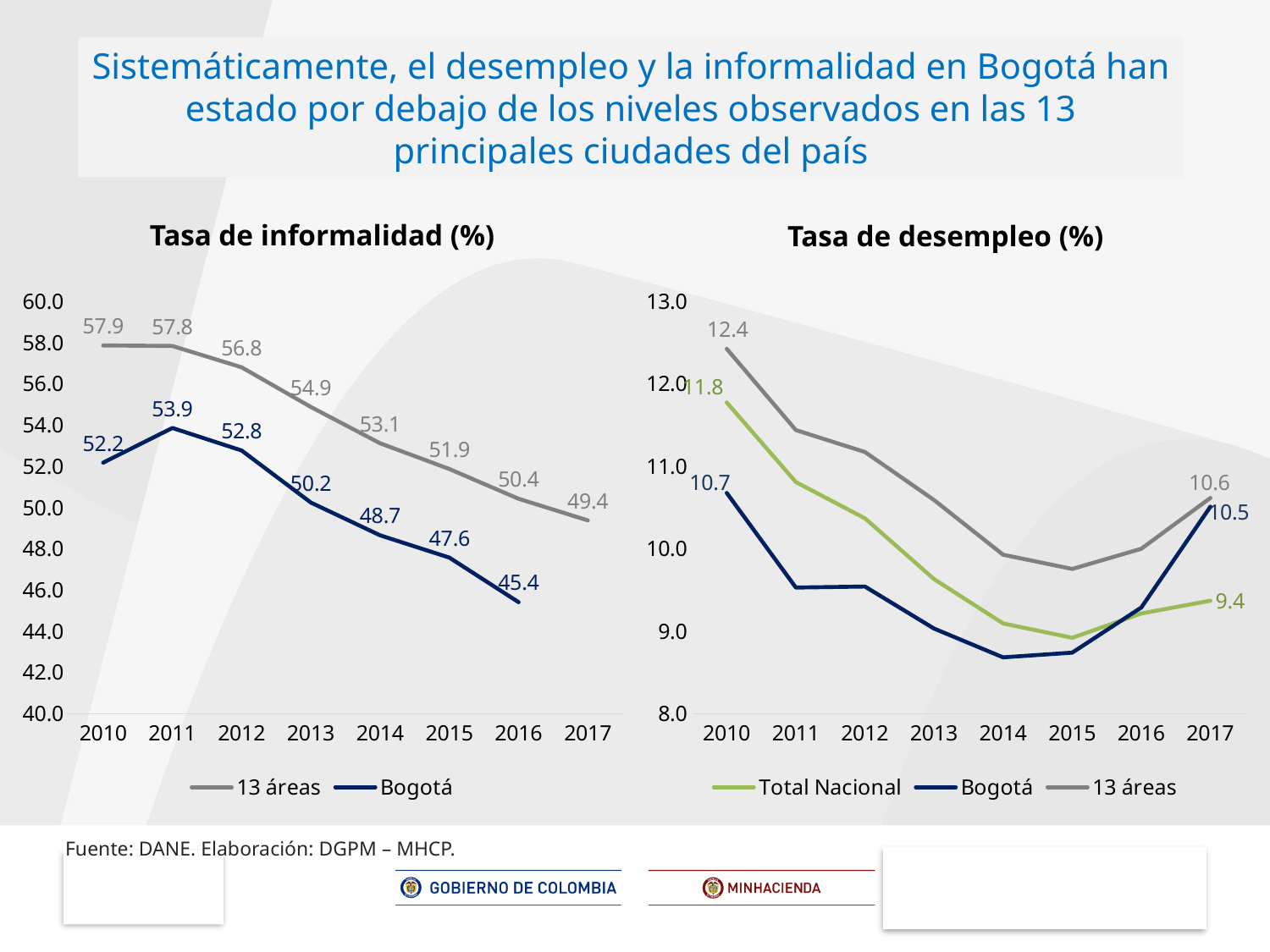
How many series does the legend of the 'Tasa de informalidad (%)' chart list? 2 In the 'Tasa de desempleo (%)' chart, which is larger in 2017: Bogotá or Total Nacional? Bogotá In the 'Tasa de informalidad (%)' chart, what is the value for Bogotá in 2011? 53.9 How many series does the legend of the 'Tasa de desempleo (%)' chart list? 3 In the 'Tasa de informalidad (%)' chart, what is the value for 13 áreas in 2014? 53.1 In the 'Tasa de informalidad (%)' chart, does the 13 áreas series rise or fall from 2010 to 2017? fall In the 'Tasa de desempleo (%)' chart, what is the value for 13 áreas in 2010? 12.4 In the 'Tasa de desempleo (%)' chart, what is the value for Total Nacional in 2017? 9.4 In the 'Tasa de desempleo (%)' chart, is the value for Bogotá in 2014 greater or less than 9.0? less In the 'Tasa de informalidad (%)' chart, in which year is the 13 áreas value highest? 2010 What kind of chart is the 'Tasa de informalidad (%)' chart? line chart In the 'Tasa de informalidad (%)' chart, what is the difference between the 13 áreas and Bogotá values in 2010? 5.7